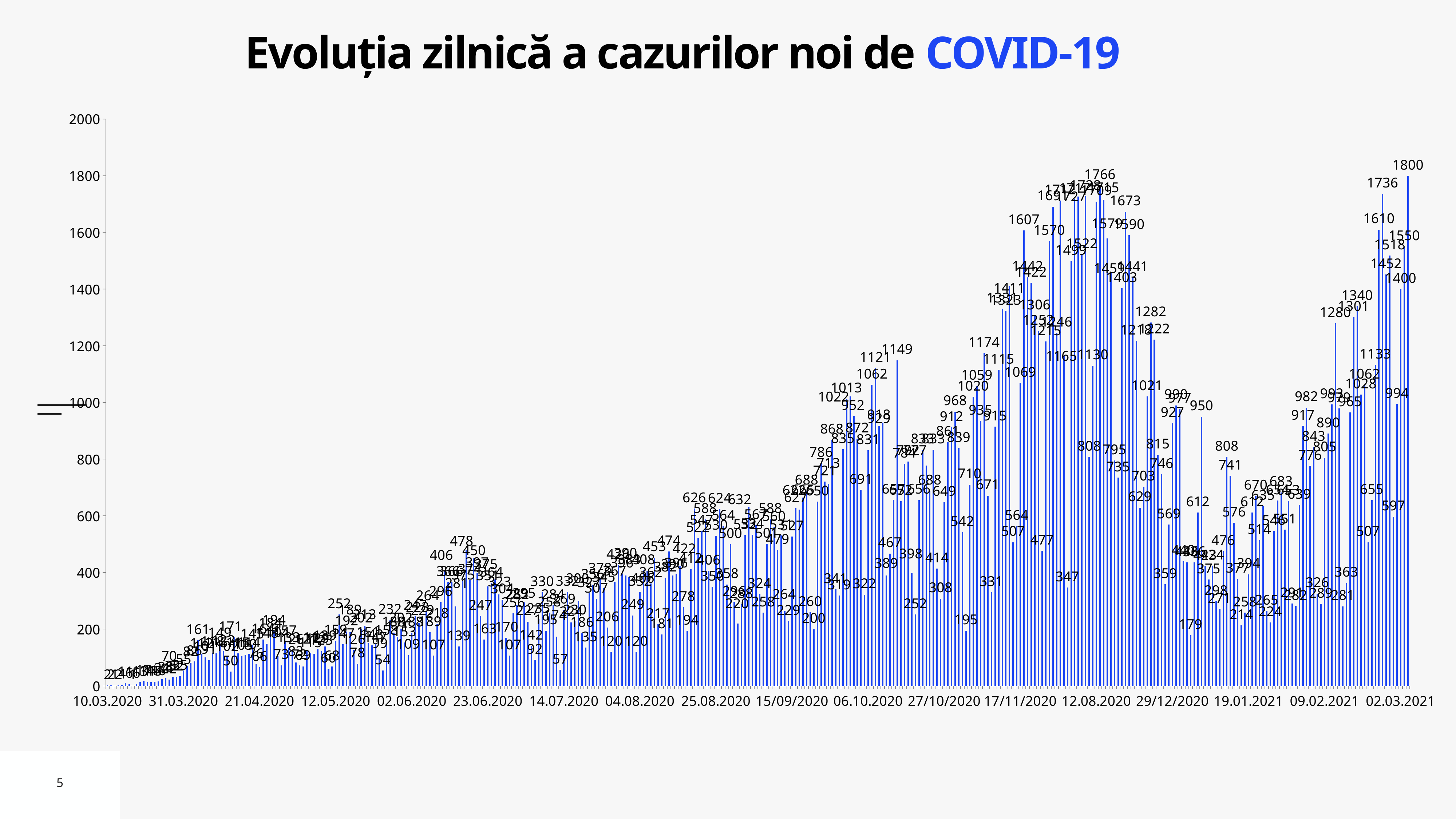
What is the difference between the highest labeled value, 1800, and the nearby value labeled 1736? 64 Is the value for 02.03.2021 greater or less than 1600? less What is the maximum value shown on the vertical axis? 2000 How many date labels are shown on the horizontal axis? 18 What is the highest value labeled on the chart? 1800 What is the title of the chart? Evoluția zilnică a cazurilor noi de COVID-19 Overall, do the daily values rise or fall from 10.03.2020 to 02.03.2021? rise Which is larger, the value for 02.03.2021 or the value for 10.03.2020? 02.03.2021 What kind of chart is shown on the slide? bar chart Is the value for 10.03.2020 greater or less than 200? less